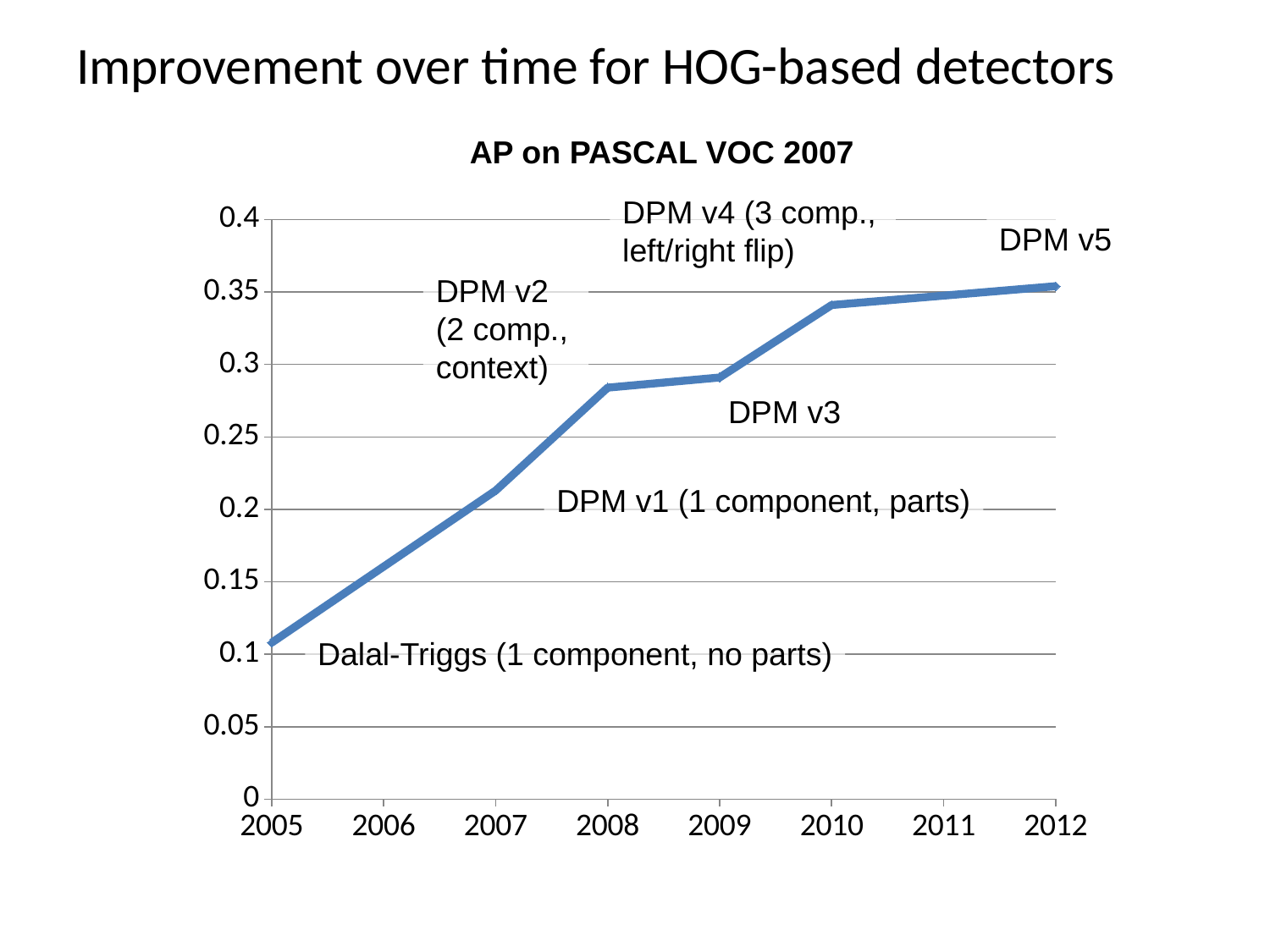
Is the value for 2010 greater or less than 0.3? greater Which is larger, the value for 2010 or the value for 2008? 2010 How many years are labelled on the x axis? 8 Which year has the lowest value on the chart? 2005 What kind of chart is shown on the slide? line chart Is the value for 2008 greater or less than 0.3? less What is the title of the chart? AP on PASCAL VOC 2007 Is the value for 2007 greater or less than 0.15? greater Do the values rise or fall from 2005 to 2012? rise Which year has the highest value on the chart? 2012